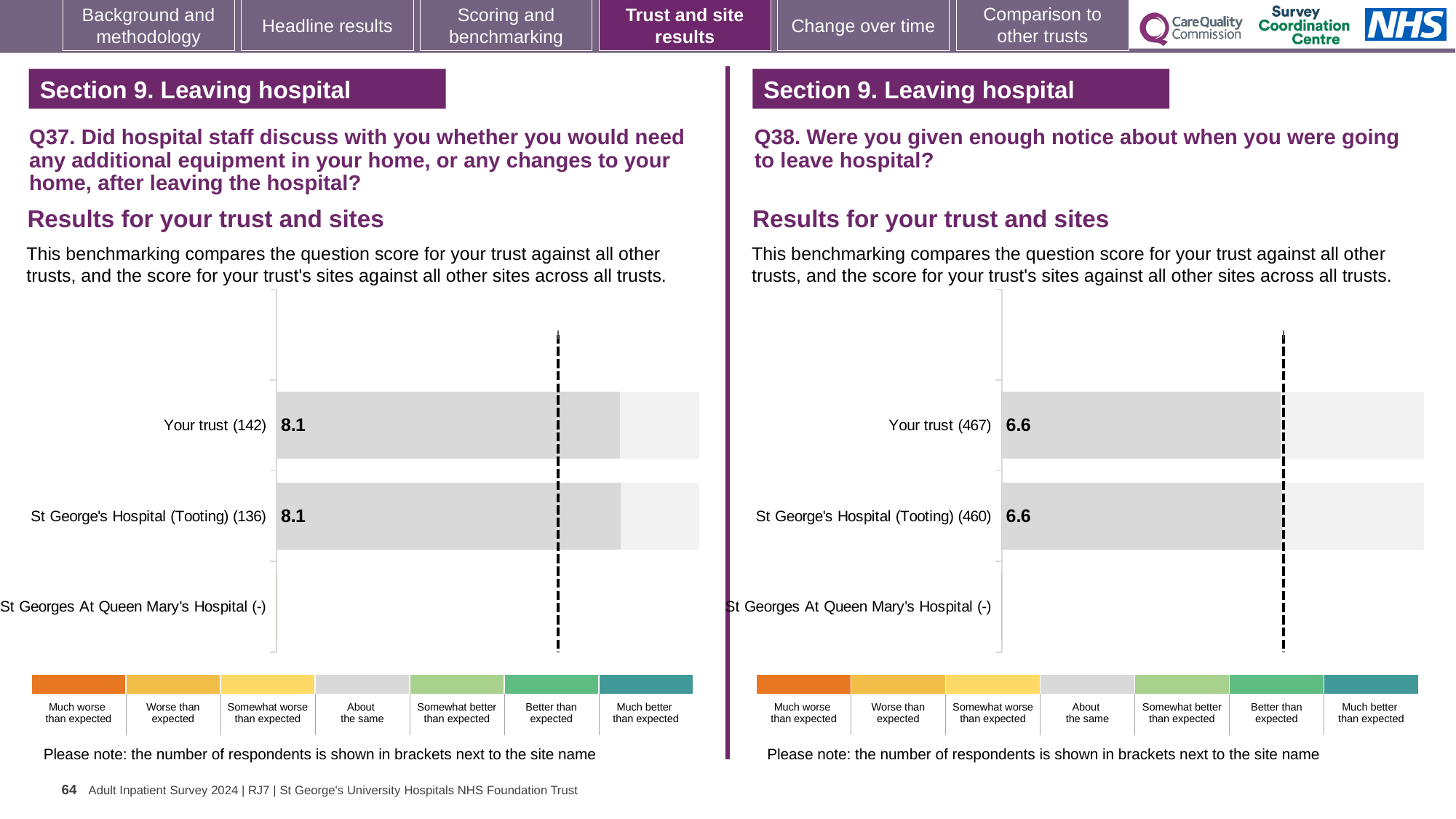
In the Q37 chart on the left, what is the score for Your trust? 8.1 In the Q38 chart on the right, how many respondents are shown in brackets for St George's Hospital (Tooting)? 460 In the Q37 chart on the left, what is the score for St George's Hospital (Tooting)? 8.1 How many categories are listed on the y axis of the Q37 chart on the left? 3 In the Q37 chart on the left, how many respondents are shown in brackets for Your trust? 142 How many categories are listed on the y axis of the Q38 chart on the right? 3 In the Q38 chart on the right, what is the score for Your trust? 6.6 Is the score for Your trust in the Q37 chart on the left larger or smaller than the score for Your trust in the Q38 chart on the right? Larger What kind of chart is the Q37 chart on the left? Bar chart In the Q38 chart on the right, what is the score for St George's Hospital (Tooting)? 6.6 In the Q38 chart on the right, what is the difference between the score for Your trust and the score for St George's Hospital (Tooting)? 0 In the Q37 chart on the left, what is the difference between the score for Your trust and the score for St George's Hospital (Tooting)? 0